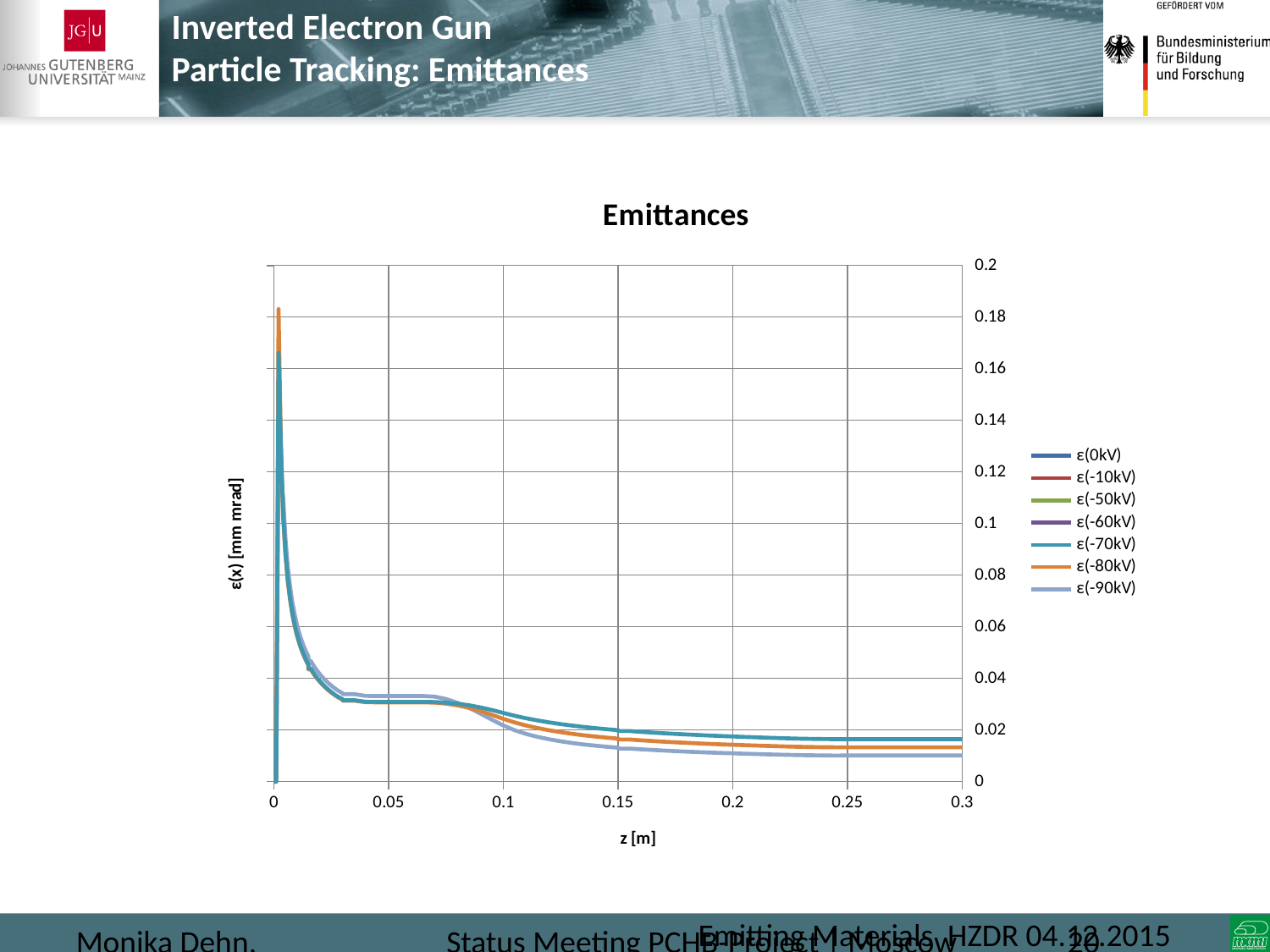
In the Emittances chart, which series has the lowest value at z = 0.3? ε(-90kV) In the Emittances chart, at z = 0.2, which is larger: ε(-70kV) or ε(-90kV)? ε(-70kV) What is the title of the chart? Emittances In the Emittances chart, do the emittance values rise or fall along the x axis after the initial peak near z = 0? fall In the Emittances chart, is the value of ε(-90kV) at z = 0.3 greater or less than 0.02? less What is the label of the x axis of the Emittances chart? z [m] In the Emittances chart, is the peak value of ε(-80kV) near z = 0 greater or less than 0.16? greater What kind of chart is shown on the slide? line chart In the Emittances chart, is the value of ε(-70kV) at z = 0.3 greater or less than 0.04? less In the Emittances chart, at z = 0.3, which is larger: ε(-80kV) or ε(-90kV)? ε(-80kV) How many series does the legend of the Emittances chart list? 7